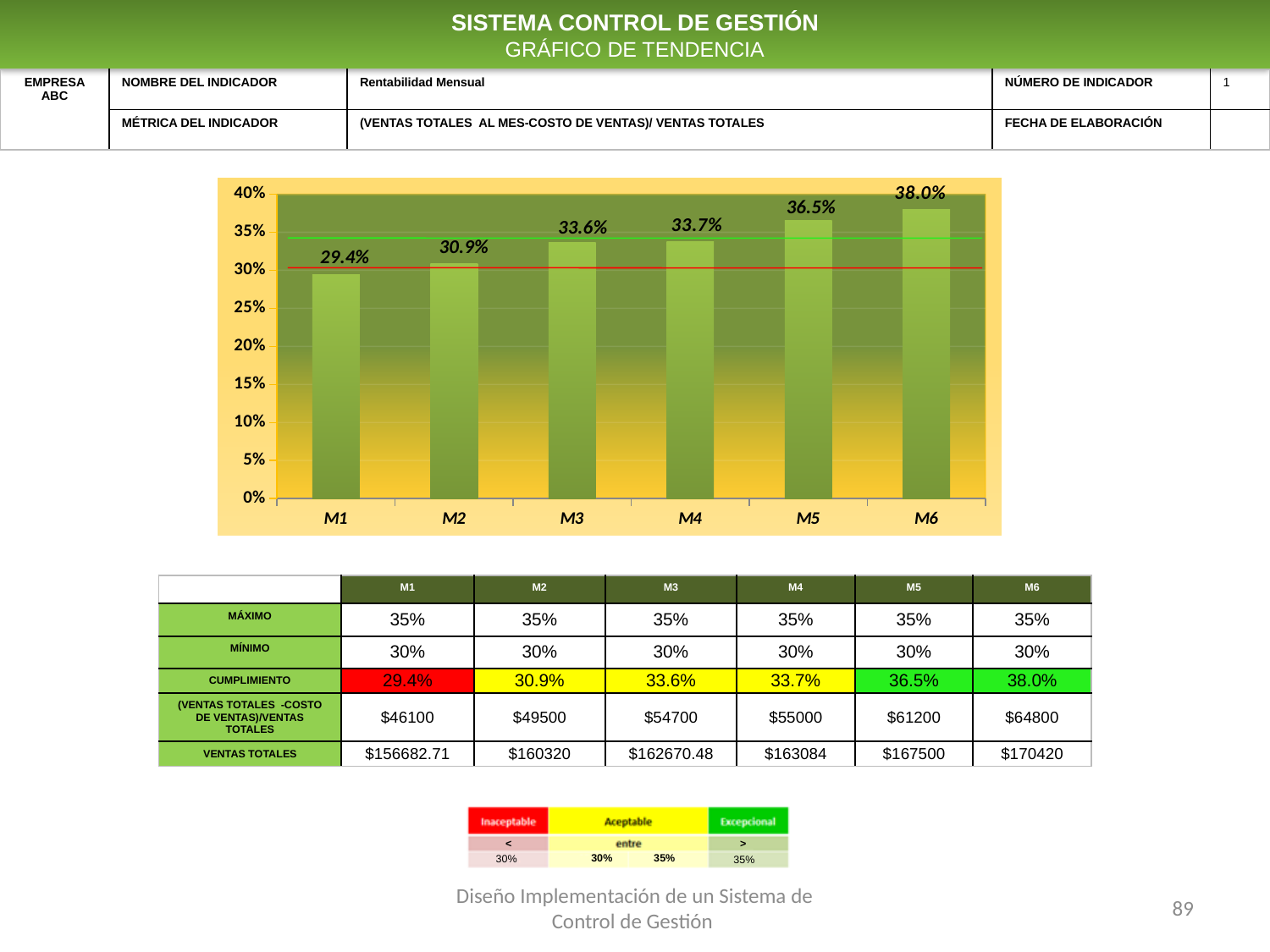
What is the value for M1 in the bar chart? 29.4% What is the difference between the values for M5 and M2 in the bar chart? 5.6% Is the value for M2 in the bar chart greater or less than 35%? less What is the difference between the values for M6 and M1 in the bar chart? 8.6% Which month has the lowest value in the bar chart? M1 What is the value for M4 in the bar chart? 33.7% Do the values in the bar chart rise or fall from M1 to M6? rise What is the value for M6 in the bar chart? 38.0% Which is larger in the bar chart, the value for M3 or the value for M5? M5 How many months are plotted in the bar chart? 6 Which month has the highest value in the bar chart? M6 What kind of chart is shown on the slide? bar chart